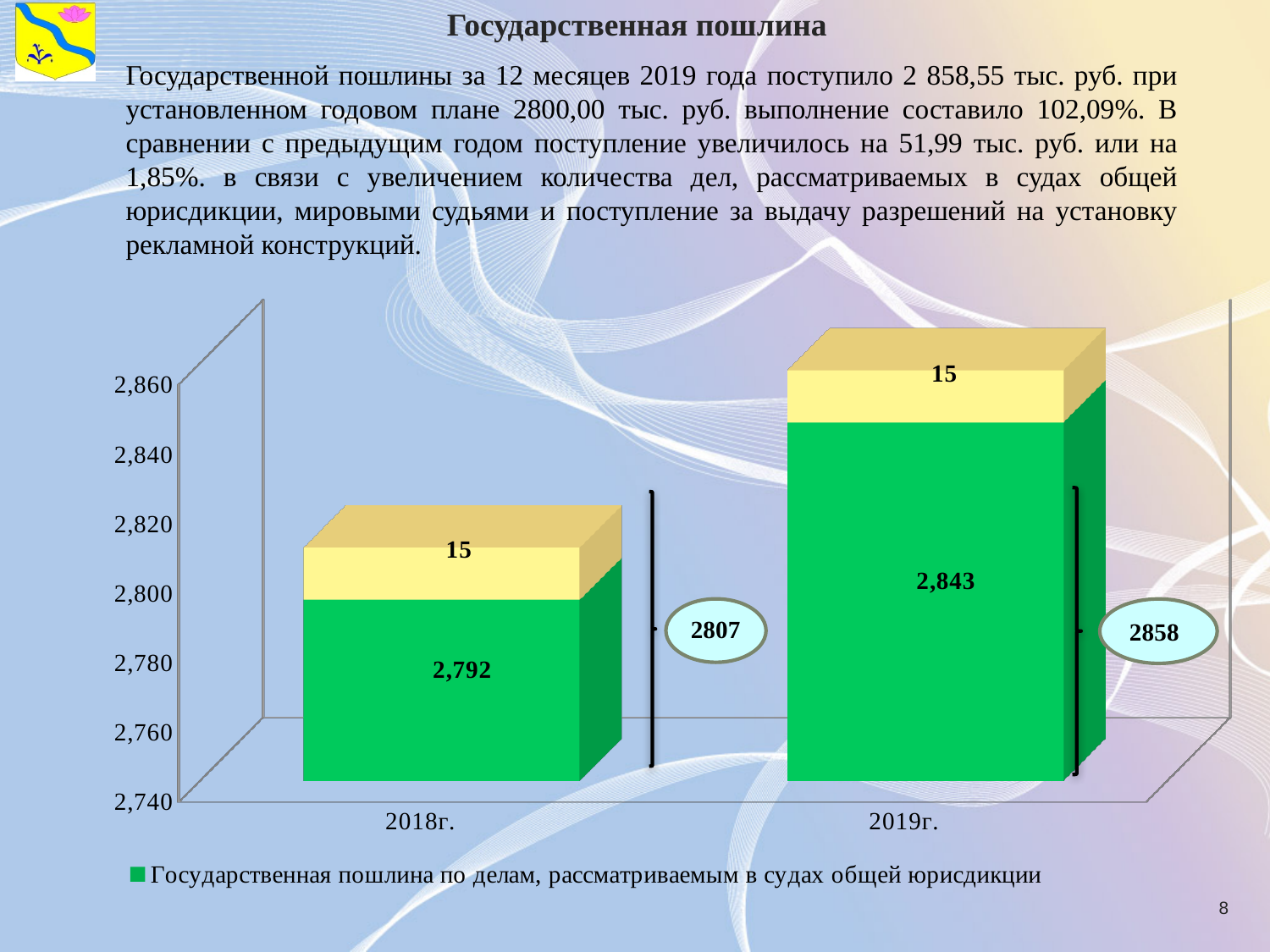
How many categories are shown on the x axis of the chart? 2 Which year has the higher value for the green segment, 2018г. or 2019г.? 2019г. What is the difference between the green segment values for 2019г. and 2018г.? 51 Do the green segment values rise or fall from 2018г. to 2019г.? rise How many series does the legend list? 1 What is the value of the yellow segment for 2019г.? 15 What is the total shown for the 2018г. bar? 2807 What is the title of the slide containing the chart? Государственная пошлина What is the value of the green segment for 2019г.? 2,843 What is the value of the green segment for 2018г.? 2,792 What is the total shown for the 2019г. bar? 2858 What type of chart is shown on the slide? bar chart